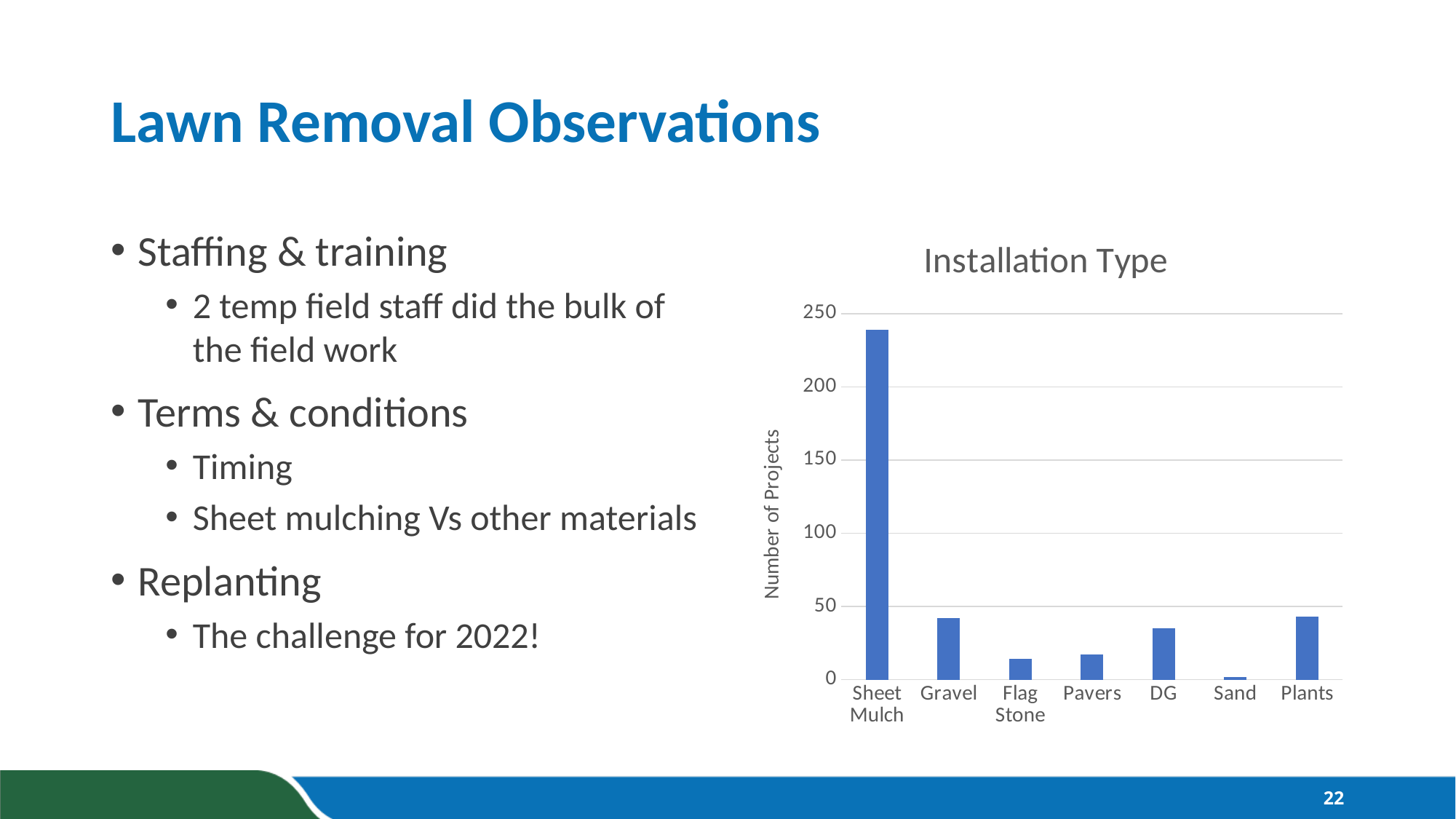
Is the number of projects for Sheet Mulch greater or less than 200? greater Which installation type has the highest number of projects? Sheet Mulch Is the number of projects for DG greater or less than 50? less Which has more projects, Sheet Mulch or Gravel? Sheet Mulch Which has more projects, DG or Flag Stone? DG How many installation types are shown on the x axis of the chart? 7 Is the number of projects for Sheet Mulch greater or less than 250? less What type of chart is shown on the slide? bar chart What is the label on the vertical axis of the chart? Number of Projects Which installation type has the lowest number of projects? Sand What is the title of the chart? Installation Type